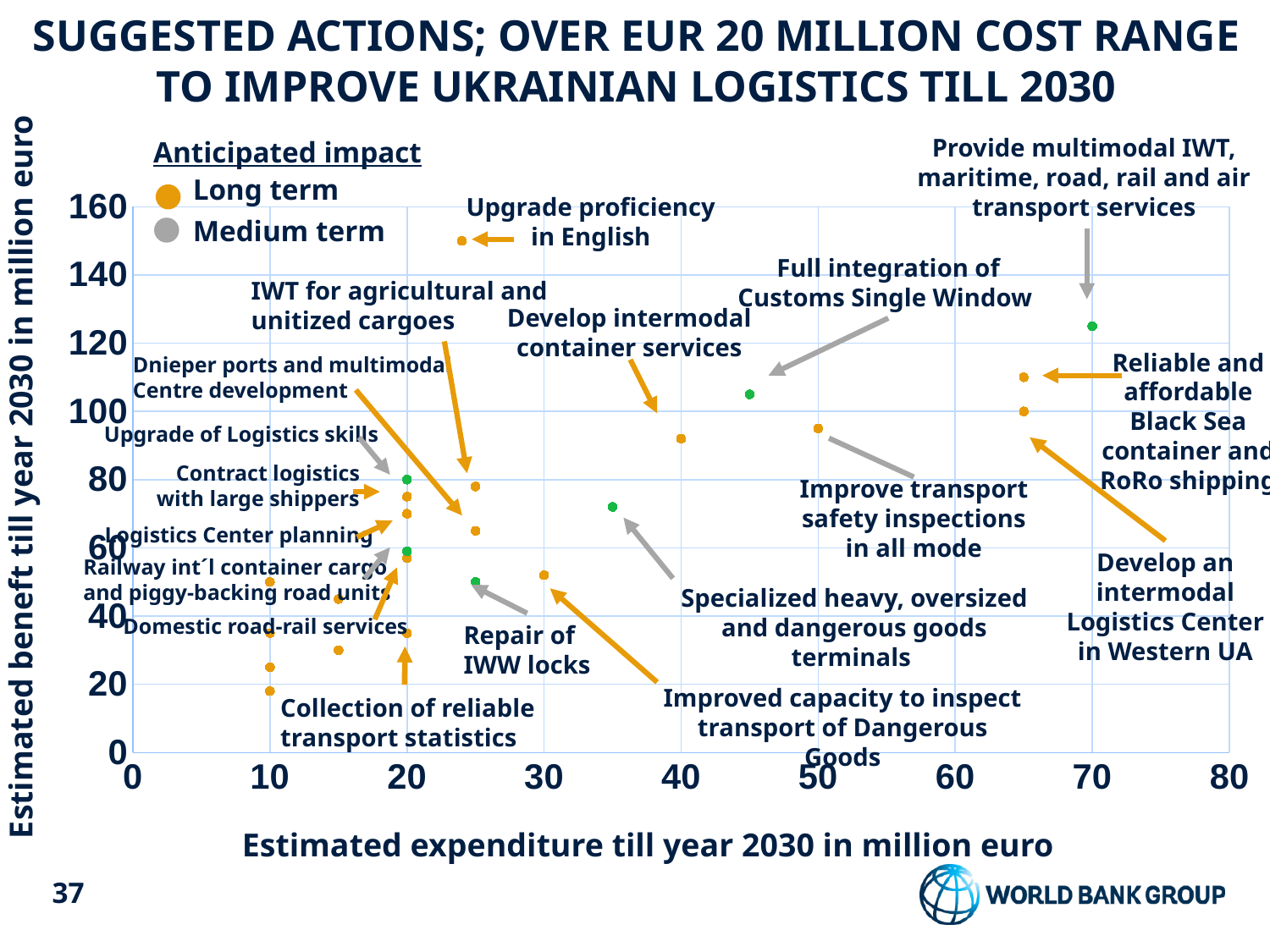
How many series does the legend list under 'Anticipated impact'? 2 Is the estimated benefit for 'Upgrade proficiency in English' greater or less than 140? greater Is the estimated benefit for 'Full integration of Customs Single Window' greater or less than 100? greater What is the title of the horizontal axis? Estimated expenditure till year 2030 in million euro What is the estimated expenditure for 'Improve transport safety inspections in all mode'? 50 Which action has the highest estimated benefit on the chart? Upgrade proficiency in English Is the estimated benefit for 'Develop intermodal container services' greater or less than 100? less Which has the higher estimated benefit: 'Full integration of Customs Single Window' or 'Develop intermodal container services'? Full integration of Customs Single Window What is the estimated expenditure for 'Develop intermodal container services'? 40 Which action has the highest estimated expenditure on the chart? Provide multimodal IWT, maritime, road, rail and air transport services What is the estimated expenditure for 'Provide multimodal IWT, maritime, road, rail and air transport services'? 70 What kind of chart is shown on the slide? scatter chart